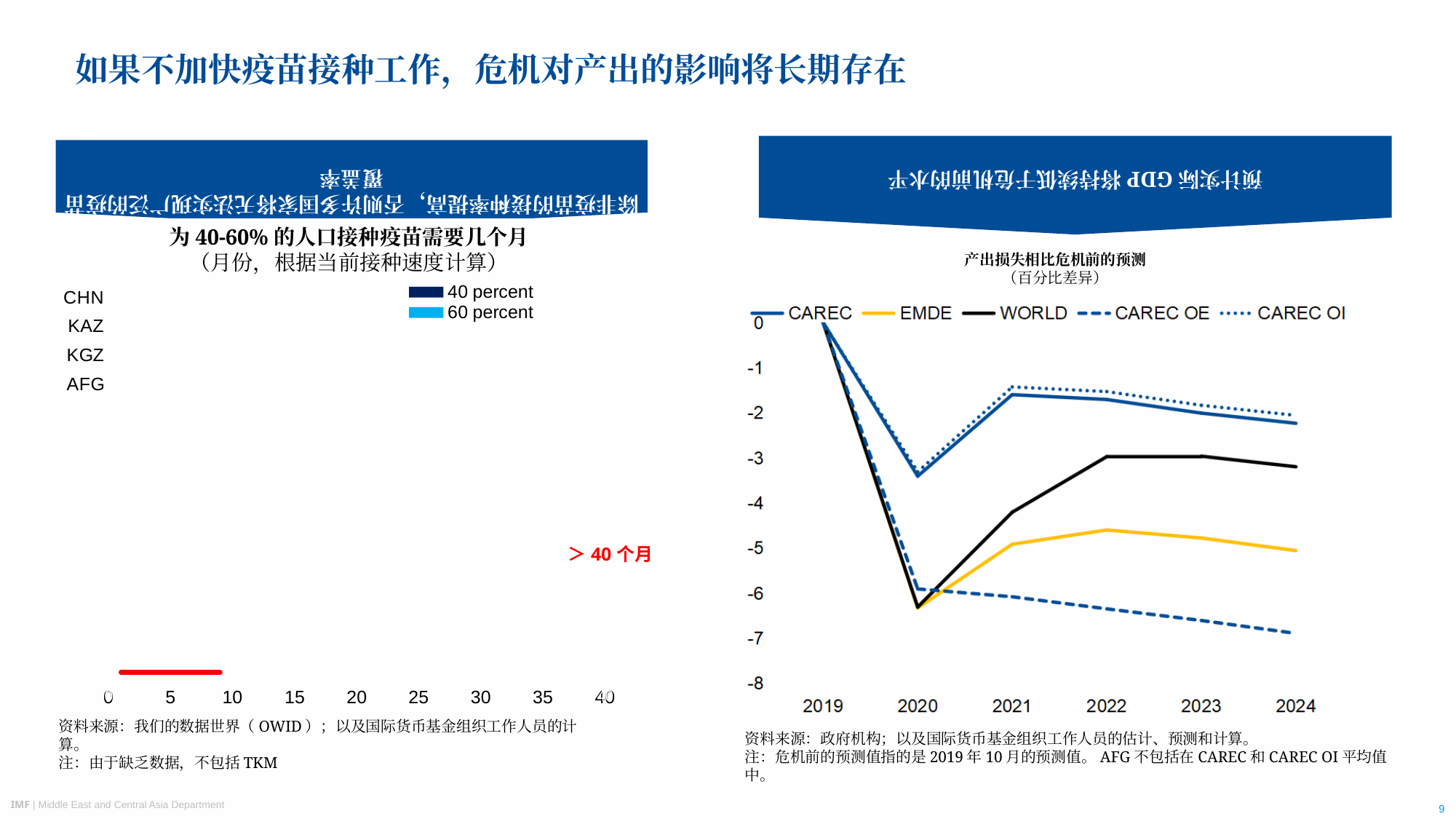
How many series does the legend of the left-hand chart (为 40-60% 的人口接种疫苗需要几个月) list? 2 In the right-hand chart (产出损失相比危机前的预测), is the value for CAREC in 2020 greater or less than -3? less In the right-hand chart (产出损失相比危机前的预测), is the value for WORLD in 2020 greater or less than -6? less How many series does the legend of the right-hand chart (产出损失相比危机前的预测) list? 5 In the right-hand chart (产出损失相比危机前的预测), which series has the lowest value in 2020? WORLD In the right-hand chart (产出损失相比危机前的预测), is the value for EMDE in 2022 greater or less than -5? greater In the right-hand chart (产出损失相比危机前的预测), does the CAREC OE series rise or fall from 2020 to 2024? fall In the right-hand chart (产出损失相比危机前的预测), which is larger in 2023, WORLD or EMDE? WORLD How many categories are listed on the left-hand chart (为 40-60% 的人口接种疫苗需要几个月)? 4 How many years are shown on the x axis of the right-hand chart (产出损失相比危机前的预测)? 6 What kind of chart is the right-hand chart titled 产出损失相比危机前的预测? line chart In the right-hand chart (产出损失相比危机前的预测), which series has the lowest value in 2024? CAREC OE